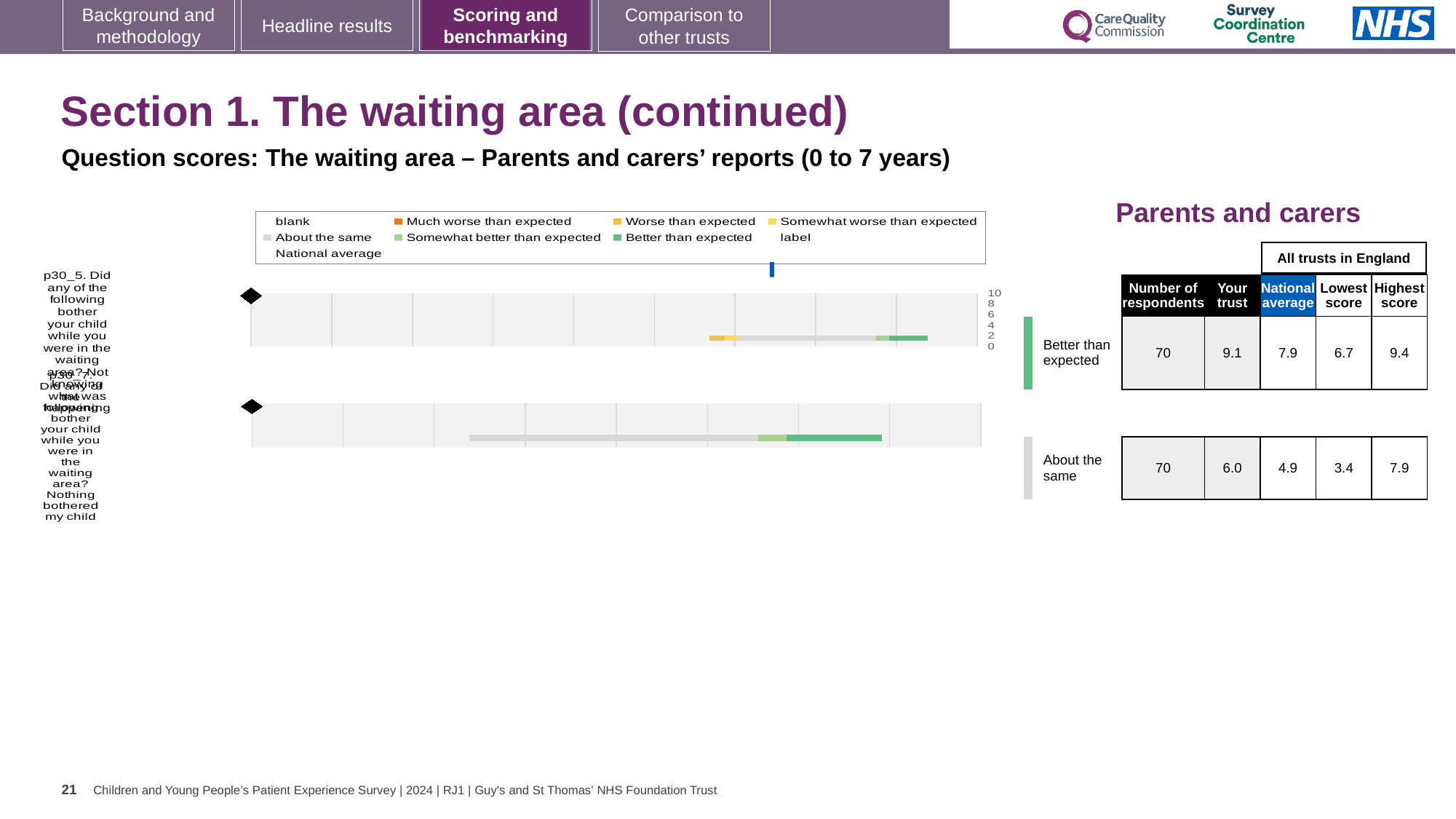
How many question bars are plotted in the chart? 2 By how much does the trust's score exceed the national average for the question rated 'Better than expected'? 1.2 What is the highest value shown on the chart's axis? 10 How many entries does the chart legend list? 9 How many respondents answered the question rated 'Better than expected'? 70 In the table, what is the 'Your trust' score for the question rated 'Better than expected'? 9.1 In the table, what is the national average for the question rated 'About the same'? 4.9 What is the lowest score across all trusts in England for the question rated 'Better than expected'? 6.7 What kind of chart is shown on the slide? bar chart Which question has the higher 'Your trust' score, the one rated 'Better than expected' or the one rated 'About the same'? Better than expected What is the highest score across all trusts in England for the question rated 'About the same'? 7.9 What colour is the 'Better than expected' legend entry? green